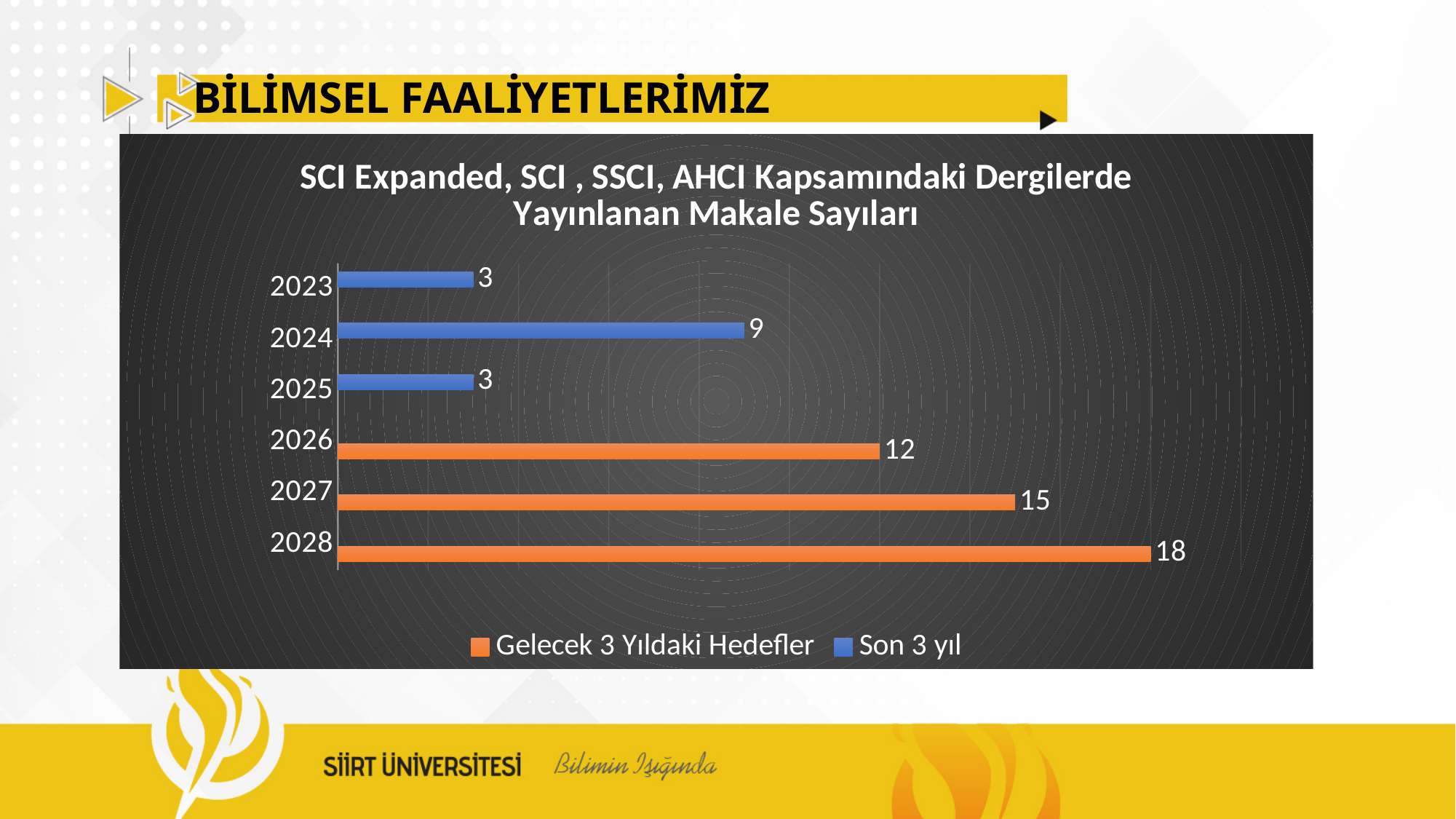
Which is larger, the value for 2026 or the value for 2024? 2026 How many years are shown on the chart? 6 What kind of chart is shown on the slide? Bar chart What is the value for 2024 in the 'Son 3 yıl' series? 9 Which year has the highest value on the chart? 2028 What is the value for 2026? 12 Which year has the highest value in the 'Son 3 yıl' series? 2024 What is the difference between the values for 2024 and 2025? 6 How many series does the legend list? 2 What is the difference between the values for 2028 and 2027? 3 What is the value for 2023? 3 What is the value for 2028 in the 'Gelecek 3 Yıldaki Hedefler' series? 18